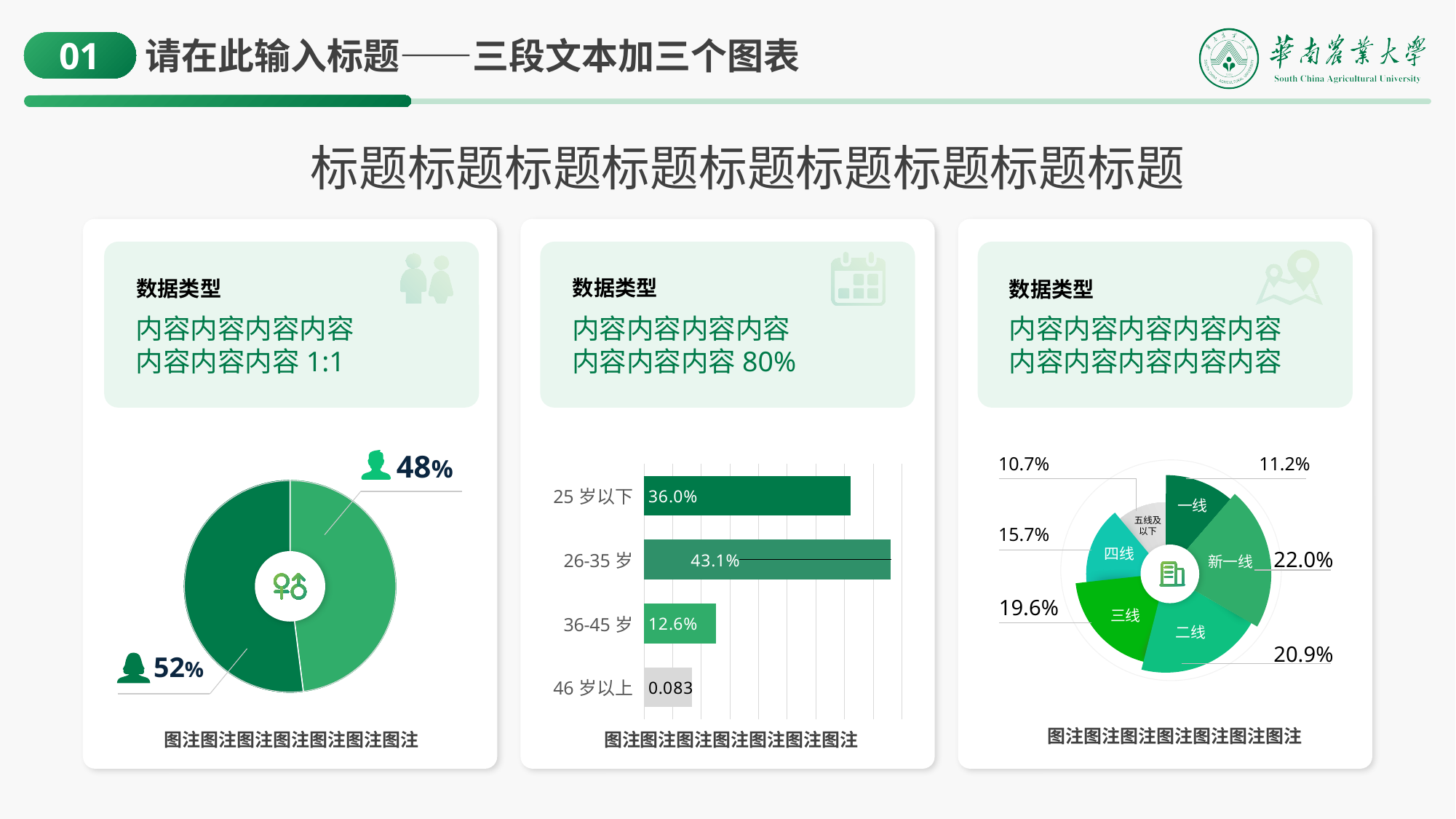
In the middle bar chart, what is the value for 36-45 岁? 12.6% How many categories are shown in the right pie chart? 6 In the middle bar chart, which age group has the lowest value? 46 岁以上 In the right pie chart, which category has the smallest share? 五线及以下 In the middle bar chart, what is the difference between the values for 25 岁以下 and 36-45 岁? 23.4% In the middle bar chart, what is the value for 26-35 岁? 43.1% In the left donut chart, what is the value for the male segment? 48% In the right pie chart, what is the share for 新一线? 22.0% In the middle bar chart, which age group has the highest value? 26-35 岁 How many age groups are shown in the middle bar chart? 4 In the left donut chart, which segment is larger, male or female? female What kind of chart is the middle chart on the slide? bar chart